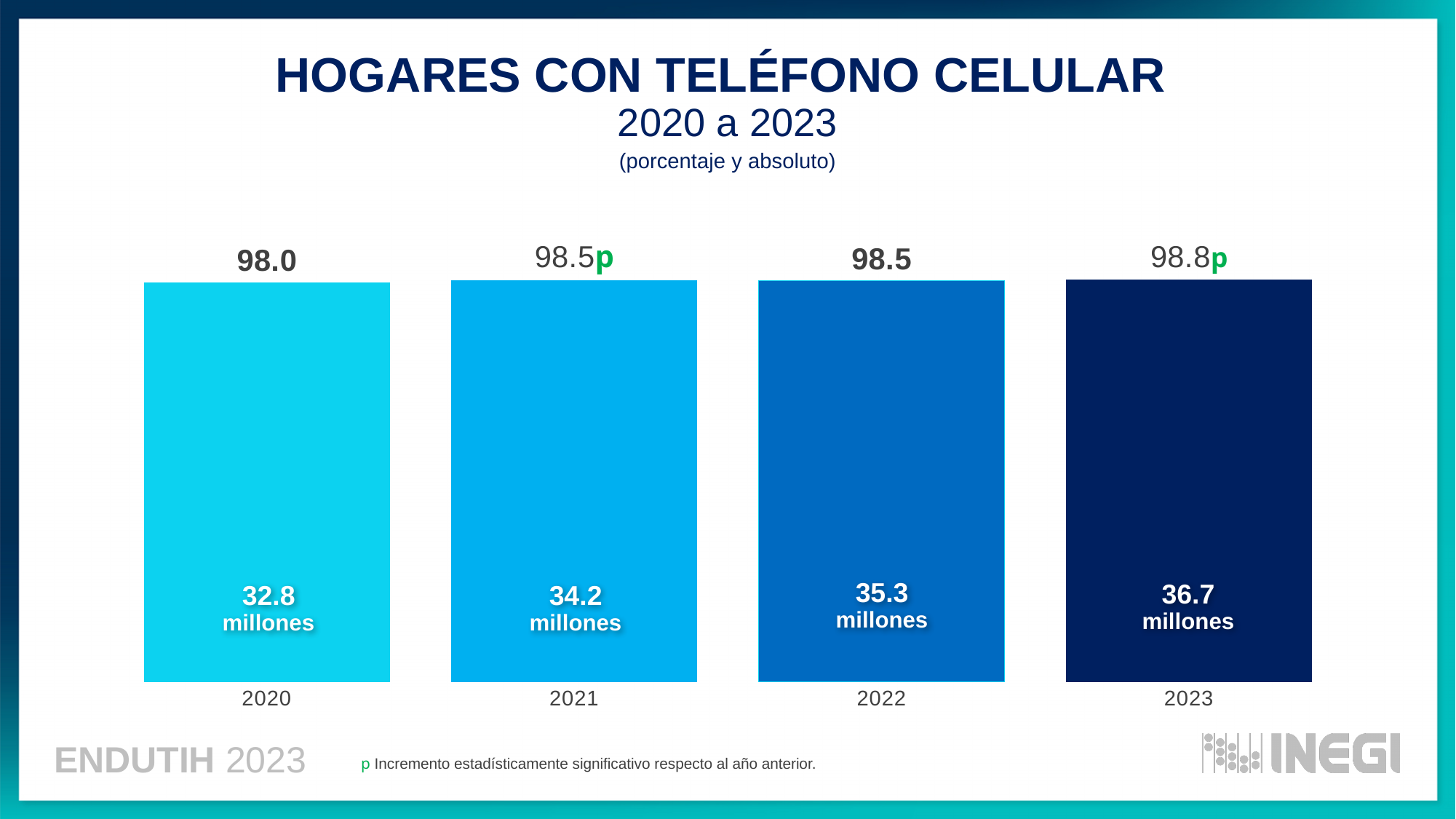
What is the difference in percentage points between 2021 and 2020? 0.5 How many years are shown in the chart? 4 What percentage of households had a cell phone in 2020? 98.0 Which year has more households with a cell phone in millions, 2021 or 2022? 2022 How many millions of households had a cell phone in 2022? 35.3 millones What percentage of households had a cell phone in 2023? 98.8 Do the absolute values in millions rise or fall from 2020 to 2023? Rise Which year has the lowest number of households with a cell phone in millions? 2020 What is the difference in millions of households between 2023 and 2020? 3.9 millones What kind of chart is shown on the slide? Bar chart Which year has the highest percentage of households with a cell phone? 2023 How many millions of households had a cell phone in 2021? 34.2 millones